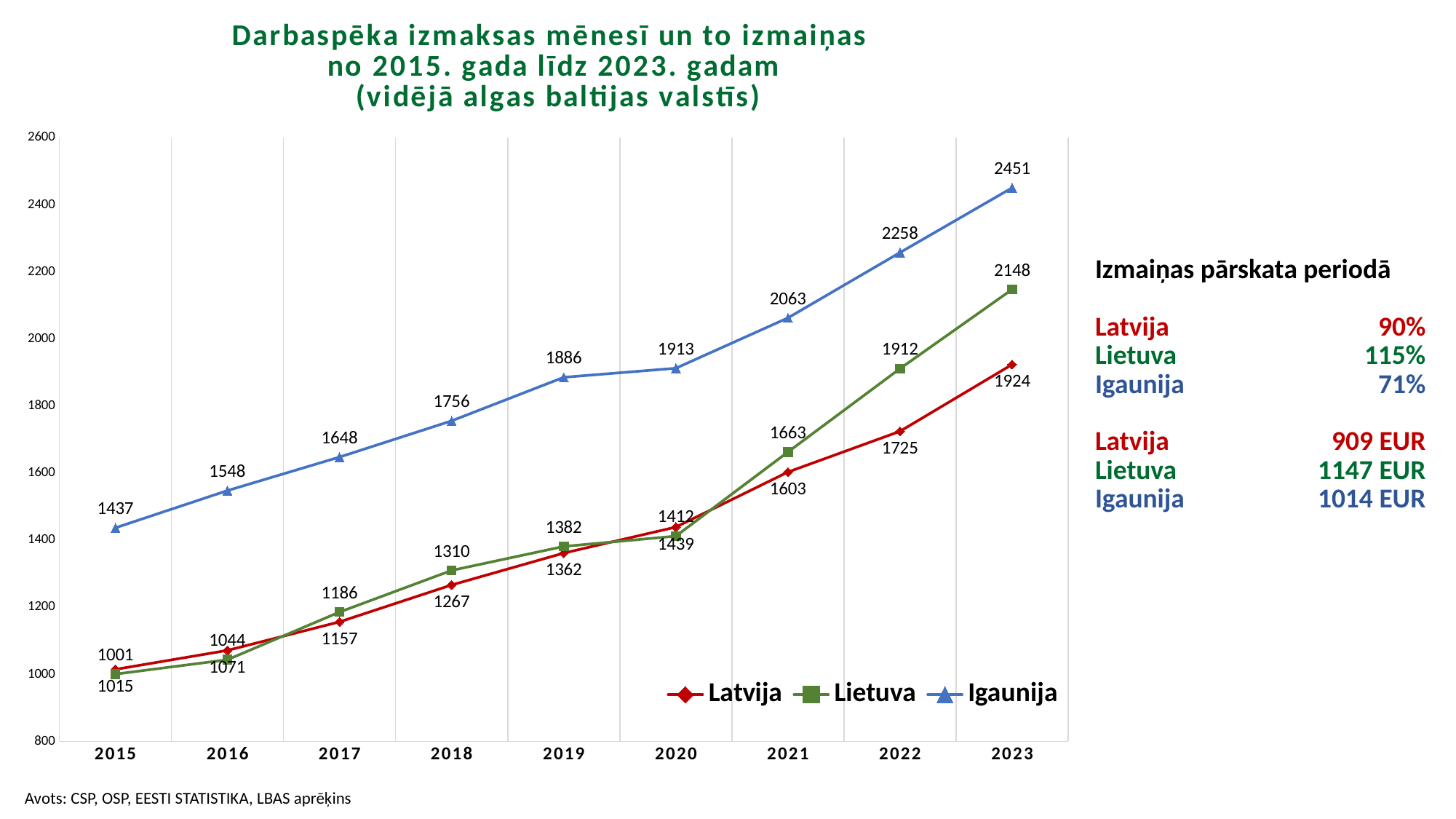
Does the Igaunija series rise or fall from 2015 to 2023? rise How many years are plotted on the x axis? 9 What is the difference between the Igaunija values in 2023 and 2015? 1014 How many series does the legend list? 3 Which series has the highest value in 2023? Igaunija Which is larger in 2019, the value for Latvija or the value for Lietuva? Lietuva What type of chart is shown on the slide? line chart Which series has the lowest value in 2022? Latvija What percentage change over the period is shown for Lietuva in the text panel? 115% What is the value for Lietuva in 2021? 1663 What is the value for Igaunija in 2023? 2451 What is the value for Latvija in 2018? 1267